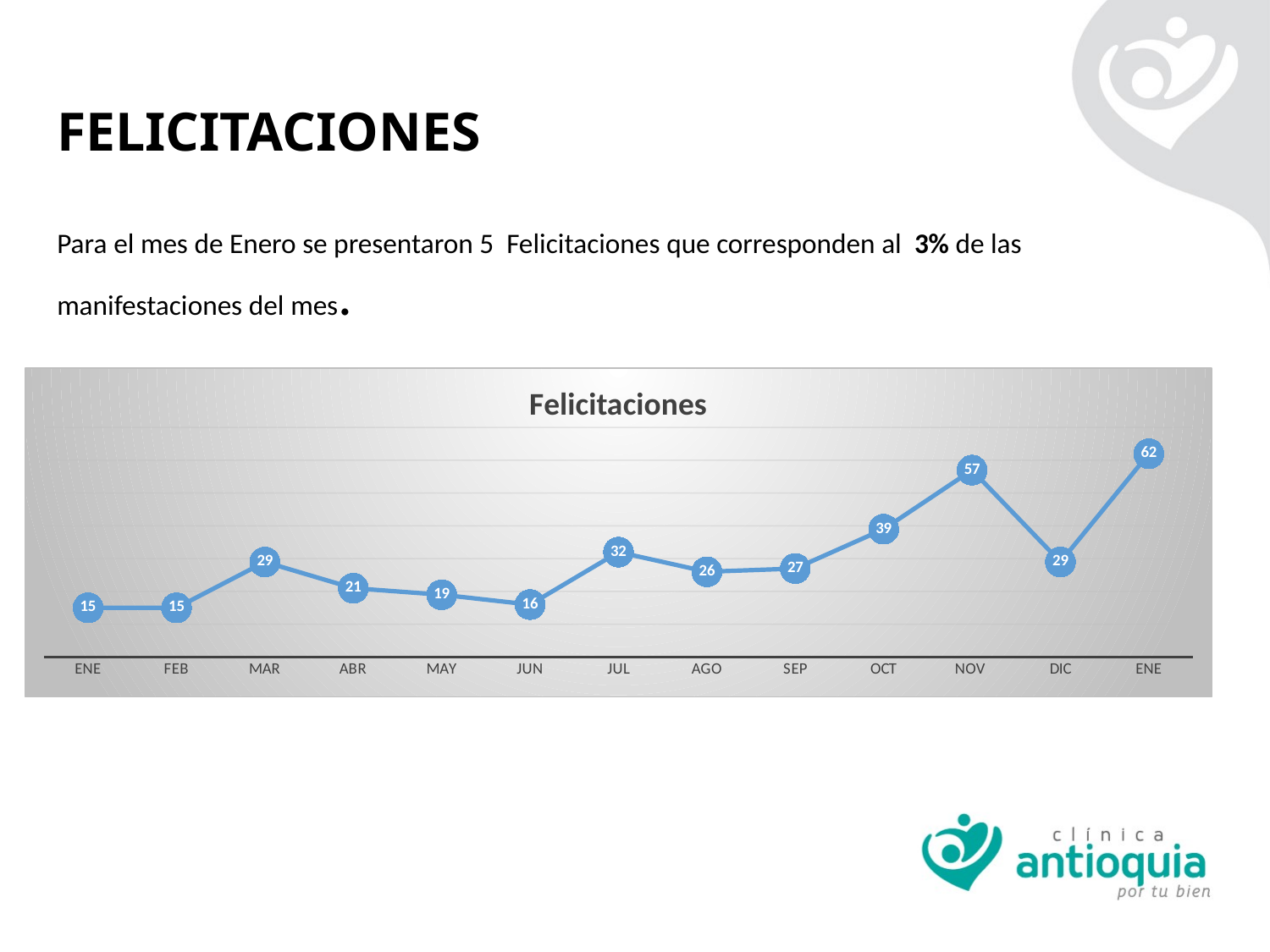
What type of chart is shown on the slide? line chart What is the value for the last ENE point on the right of the chart? 62 What is the value for MAR? 29 What is the value for JUN? 16 What is the value for NOV? 57 Do the values rise or fall from SEP to NOV? rise What is the title of the chart? Felicitaciones What is the lowest value plotted on the chart? 15 How many data points are plotted on the chart? 13 Which month has the highest value? ENE (the last point on the right) Which is larger, the value for JUL or the value for AGO? JUL What is the difference between the values for NOV and OCT? 18